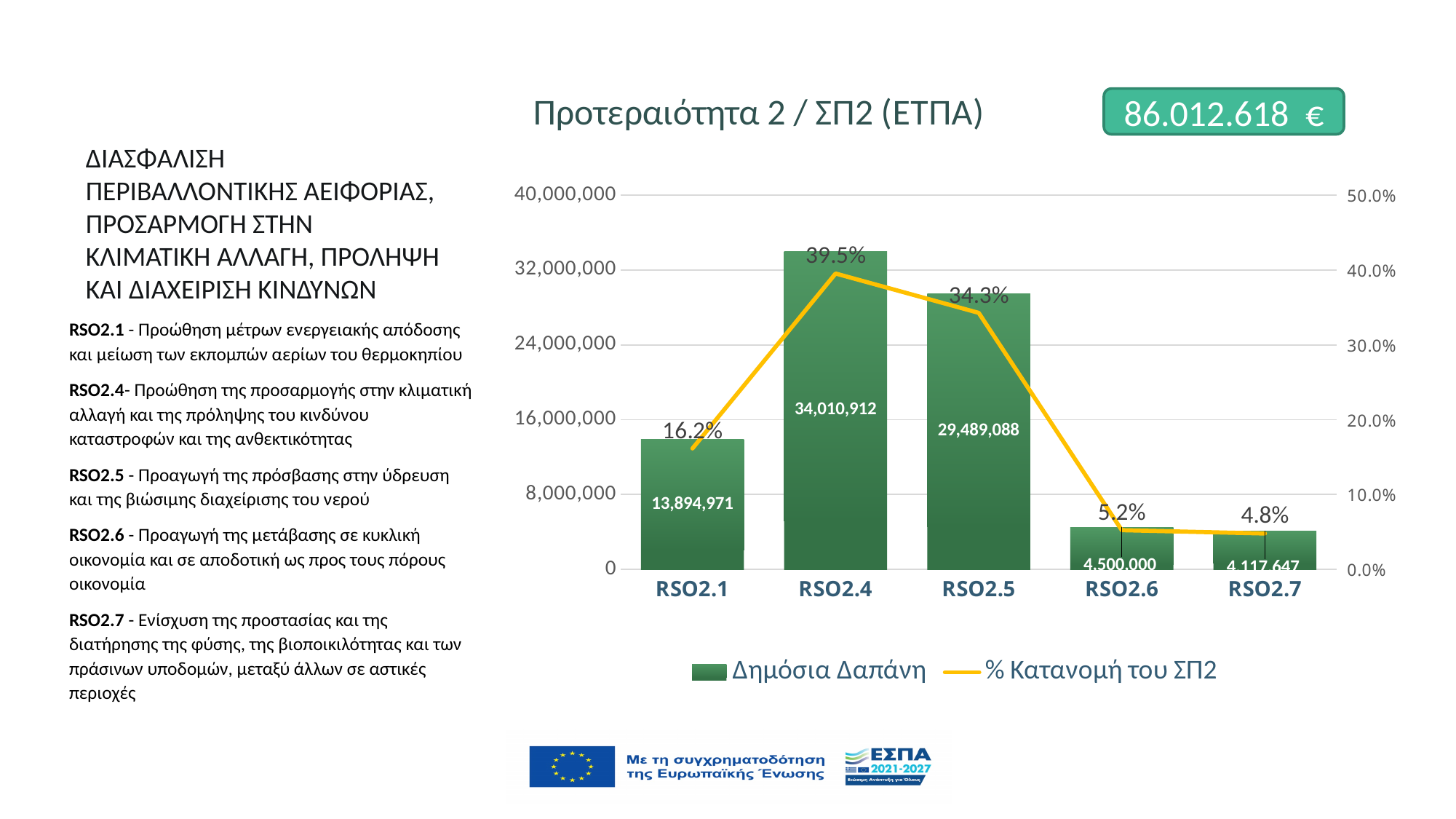
Which has a larger Δημόσια Δαπάνη, RSO2.1 or RSO2.5? RSO2.5 What percentage (% Κατανομή του ΣΠ2) is shown for RSO2.5? 34.3% Is the Δημόσια Δαπάνη for RSO2.6 greater or less than 8,000,000? less What is the title of the chart? Προτεραιότητα 2 / ΣΠ2 (ΕΤΠΑ) Which category has the lowest % Κατανομή του ΣΠ2? RSO2.7 What is the Δημόσια Δαπάνη value for RSO2.4? 34,010,912 What percentage (% Κατανομή του ΣΠ2) is shown for RSO2.7? 4.8% What is the difference in Δημόσια Δαπάνη between RSO2.4 and RSO2.5? 4,521,824 Which category has the highest Δημόσια Δαπάνη? RSO2.4 What is the Δημόσια Δαπάνη value for RSO2.1? 13,894,971 How many series does the chart legend list? 2 How many categories are shown on the x axis of the chart? 5